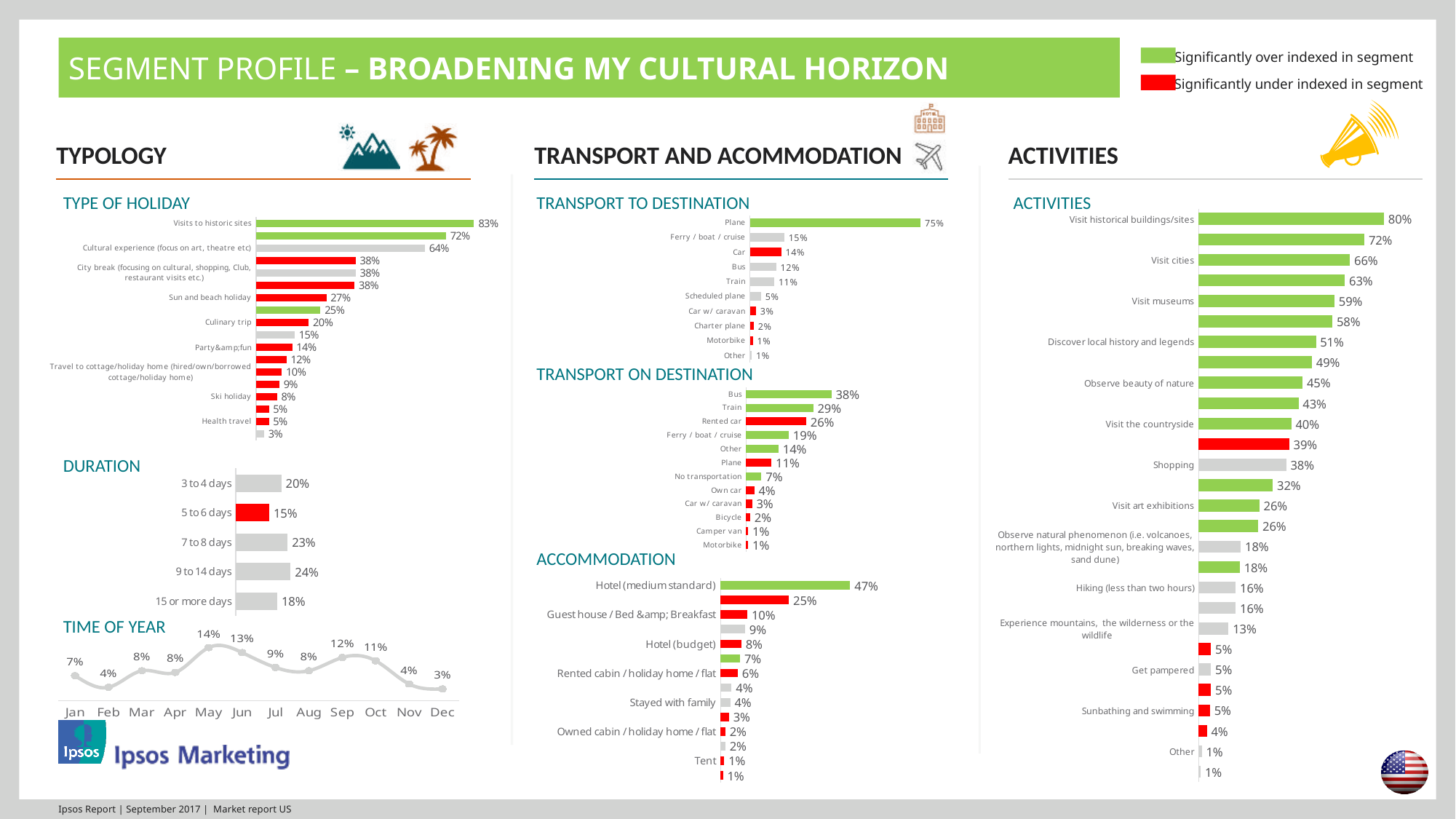
In the DURATION chart, what is the difference between the values for 7 to 8 days and 3 to 4 days? 3% In the TRANSPORT TO DESTINATION chart, what is the value for Plane? 75% In the TIME OF YEAR chart, what is the value for Sep? 12% In the ACTIVITIES chart, what is the difference between Visit historical buildings/sites and Visit cities? 14% In the TIME OF YEAR chart, which month has the highest value? May In the DURATION chart, what is the value for 9 to 14 days? 24% In the TRANSPORT ON DESTINATION chart, how many categories are plotted? 12 What kind of chart is the TIME OF YEAR chart? Line chart In the DURATION chart, which duration category has the lowest value? 5 to 6 days In the ACCOMMODATION chart, what is the value for Hotel (medium standard)? 47% In the TRANSPORT ON DESTINATION chart, which is larger, Train or Rented car? Train In the ACTIVITIES chart, what is the value for Visit museums? 59%